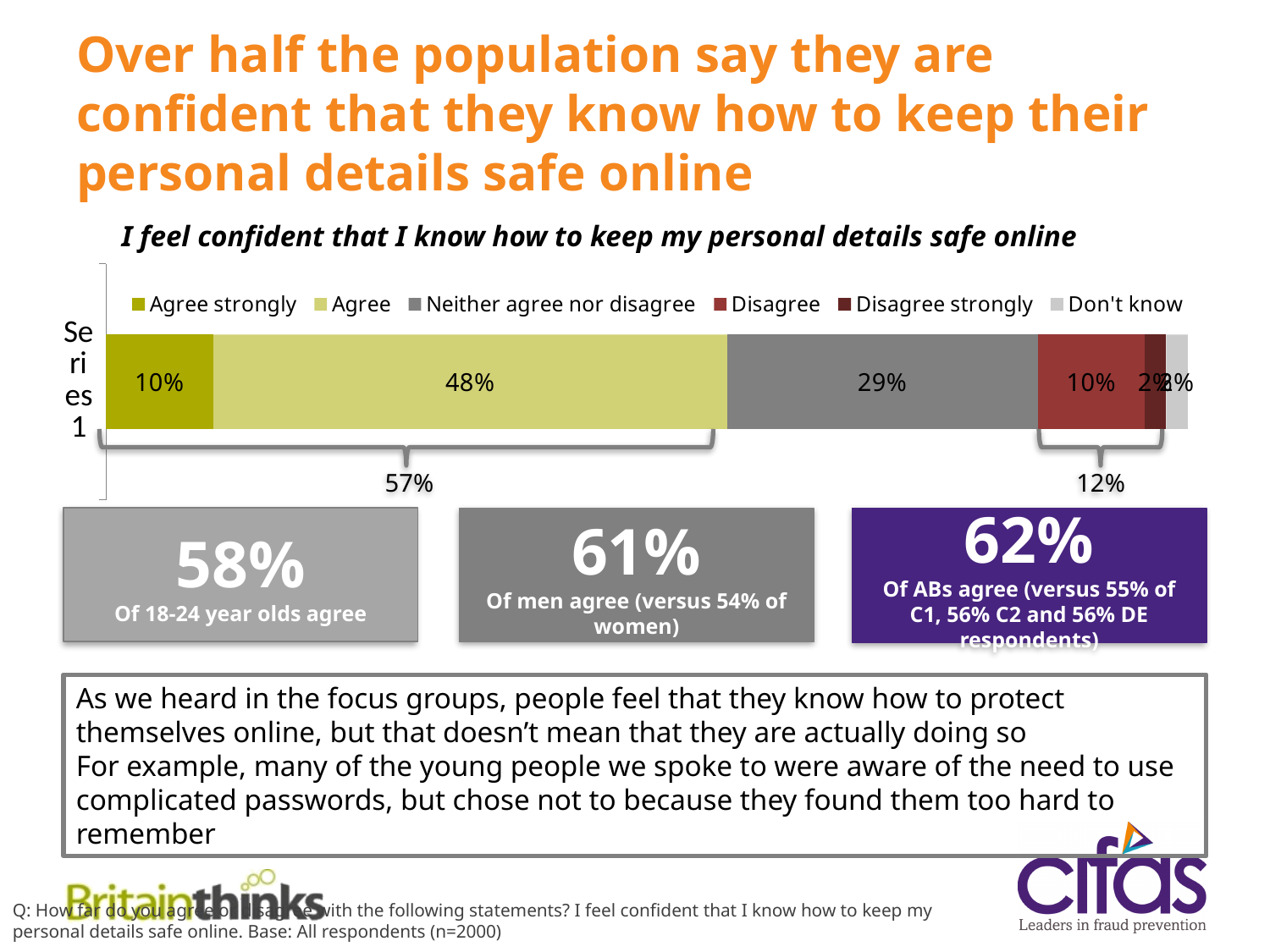
How many response options does the legend list? 6 What percentage of respondents chose "Disagree"? 10% Which is larger, the share for "Neither agree nor disagree" or the share for "Disagree"? Neither agree nor disagree What percentage of respondents chose "Neither agree nor disagree"? 29% How many bars (categories) are plotted in the chart? 1 What combined percentage is shown by the bracket under the "Agree strongly" and "Agree" segments? 57% What is the title of the chart? I feel confident that I know how to keep my personal details safe online Which response option has the largest share of the bar? Agree What is the difference between the "Agree" share and the "Neither agree nor disagree" share? 19 percentage points What percentage of respondents chose "Agree" in the chart? 48% What percentage of respondents chose "Agree strongly"? 10% What kind of chart is shown on the slide? Stacked bar chart